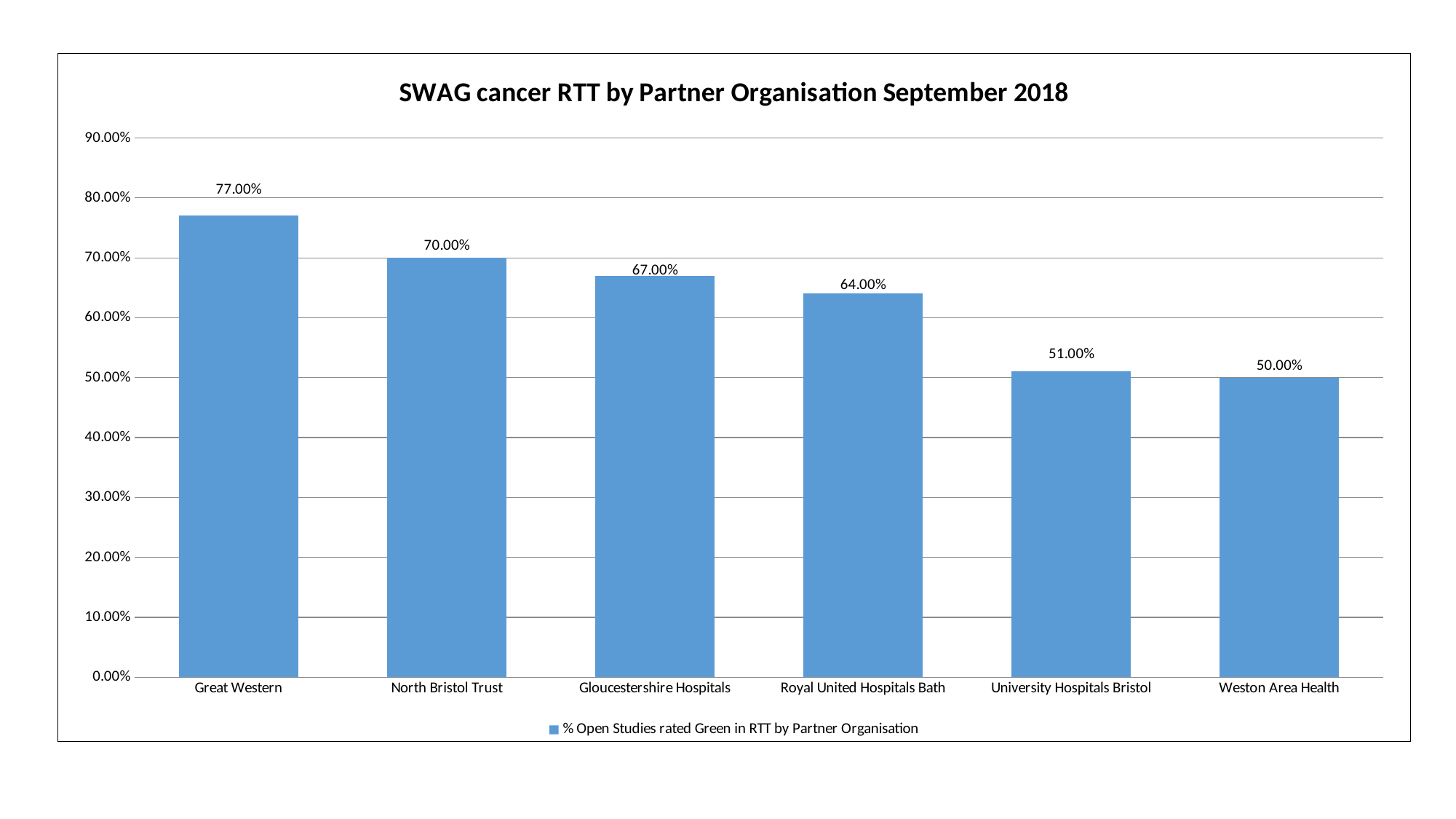
What is the value for Royal United Hospitals Bath? 64.00% Which is larger, the value for Gloucestershire Hospitals or the value for Royal United Hospitals Bath? Gloucestershire Hospitals What is the difference between the values for North Bristol Trust and Gloucestershire Hospitals? 3.00% What is the value for Weston Area Health? 50.00% Which partner organisation has the highest value? Great Western What kind of chart is shown on the slide? Bar chart How many series does the legend list? 1 What is the difference between the values for Great Western and University Hospitals Bristol? 26.00% Which partner organisation has the lowest value? Weston Area Health What is the title of the chart? SWAG cancer RTT by Partner Organisation September 2018 What is the value for Great Western? 77.00% How many partner organisations are shown on the chart? 6